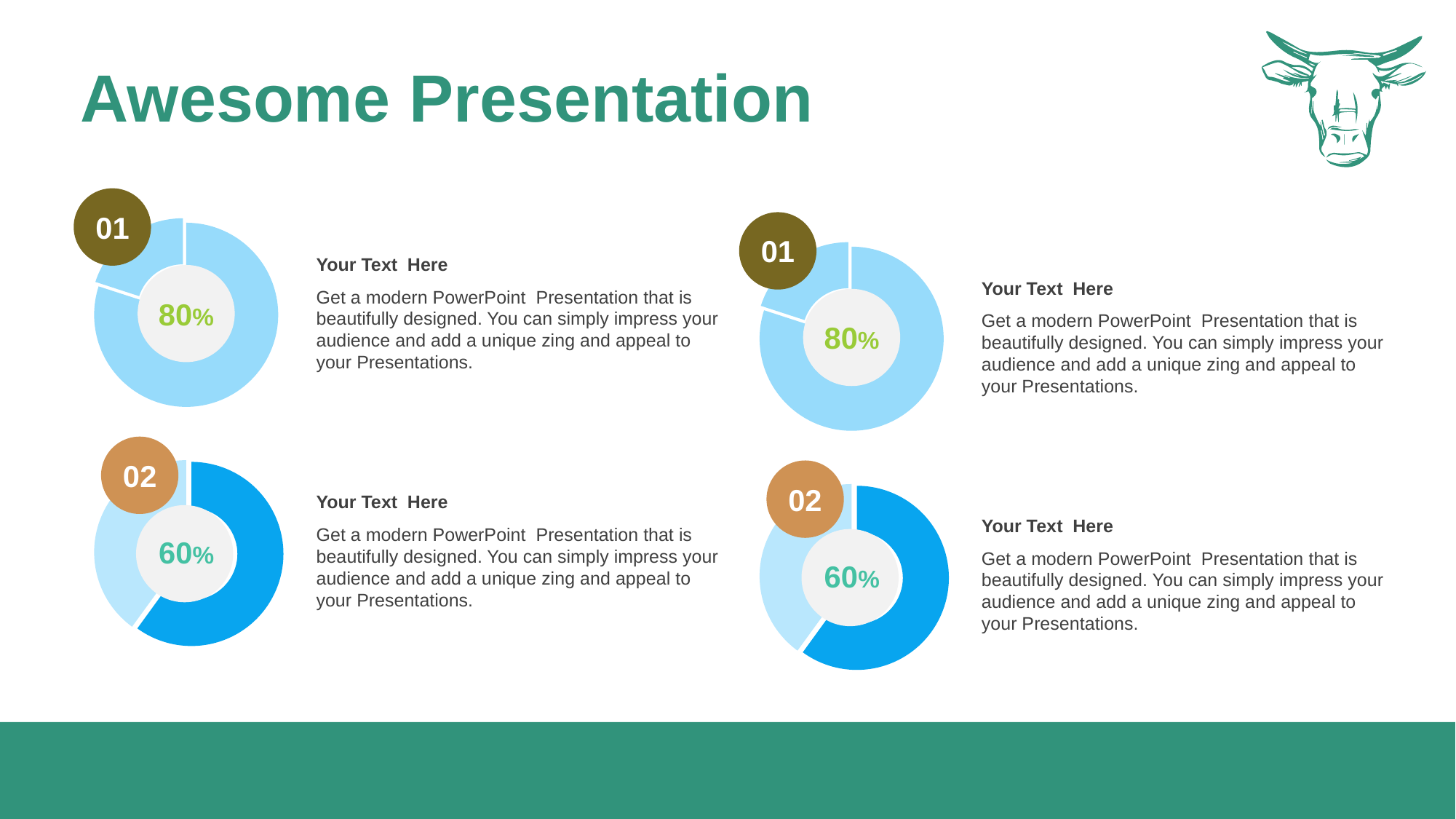
What number is shown in the badge attached to the bottom-right donut chart? 02 What percentage is shown in the centre of the top-right donut chart? 80% How many donut charts are on the slide? 4 What percentage is shown in the centre of the bottom-right donut chart? 60% Which shows a larger percentage, the top-left donut chart or the bottom-left donut chart? Top-left donut chart What percentage is shown in the centre of the top-left donut chart? 80% What kind of chart is used for the four charts on the slide? Donut (pie) chart Which donut chart on the left side of the slide shows the lowest percentage? Bottom-left donut chart Is the value shown in the bottom-left donut chart greater or less than 50%? greater What percentage is shown in the centre of the bottom-left donut chart? 60% What number is shown in the badge attached to the top-left donut chart? 01 What is the difference in percentage points between the top-right donut chart's value and the bottom-right donut chart's value? 20 percentage points